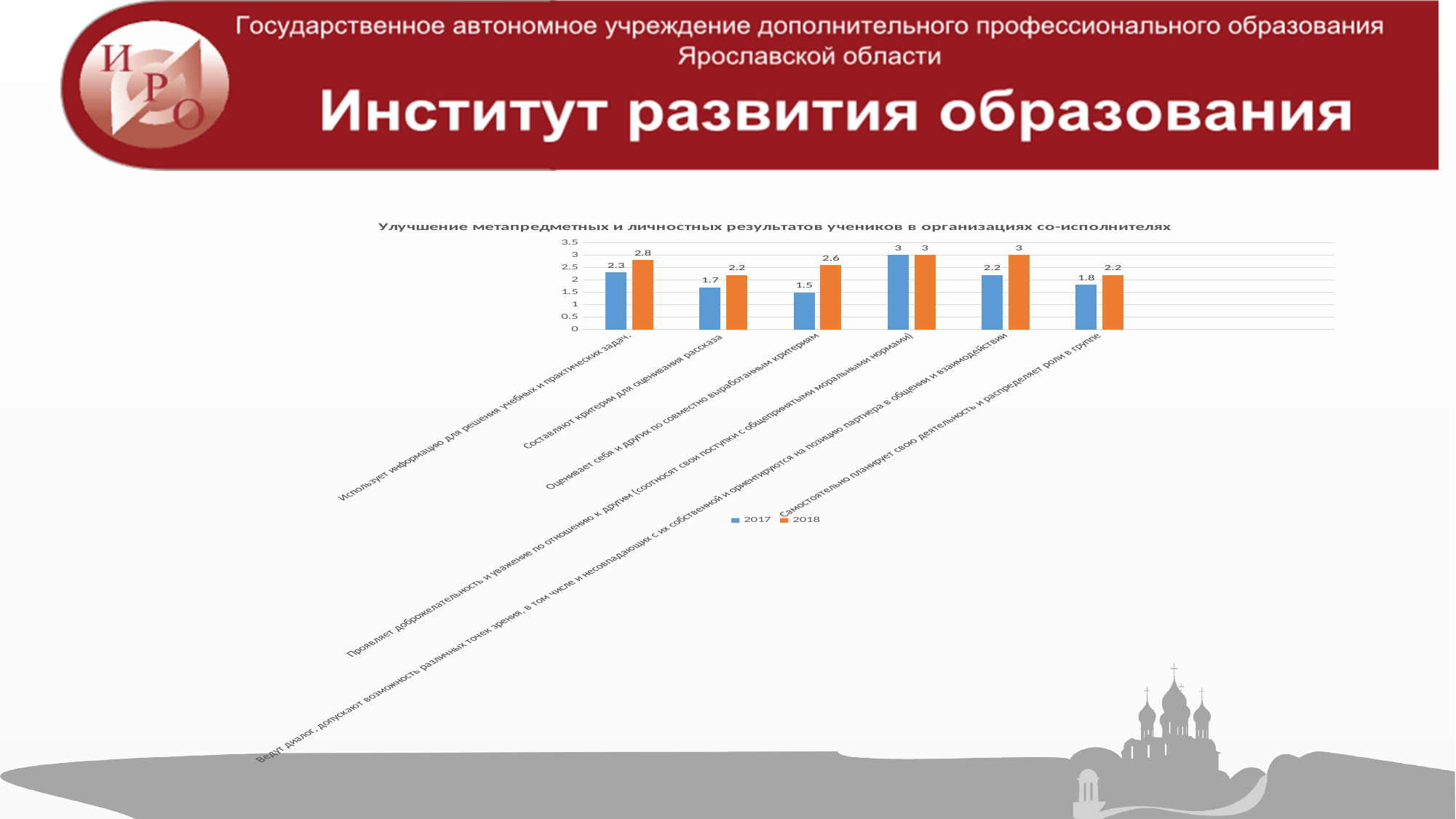
What is the 2017 value for «Использует информацию для решения учебных и практических задач»? 2.3 How many series does the legend list? 2 What kind of chart is shown on the slide? Bar chart What is the difference between the 2018 and 2017 values for «Составляют критерии для оценивания рассказа»? 0.5 What is the difference between the 2018 and 2017 values for «Оценивает себя и других по совместно выработанным критериям»? 1.1 What is the 2018 value for «Самостоятельно планирует свою деятельность и распределяет роли в группе»? 2.2 Which is larger for «Ведут диалог, допускают возможность различных точек зрения...»: the 2017 value or the 2018 value? 2018 Is the 2017 value for «Составляют критерии для оценивания рассказа» greater or less than 2? less How many categories are shown on the x axis? 6 What is the 2018 value for «Оценивает себя и других по совместно выработанным критериям»? 2.6 Which series is shown in orange? 2018 Which category has the lowest 2017 value? Оценивает себя и других по совместно выработанным критериям